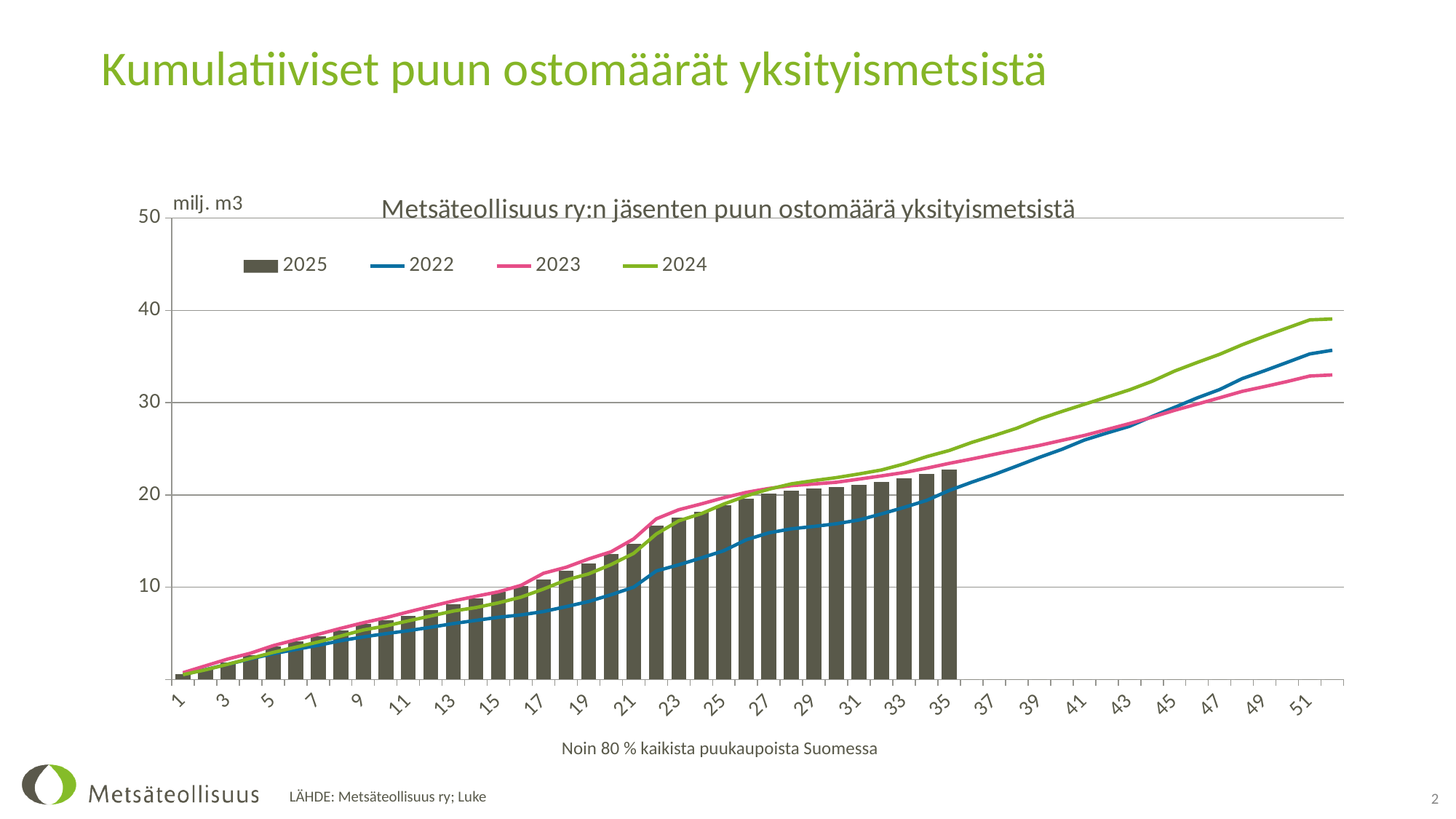
Which series has the highest value at week 51? 2024 Is the value of the 2025 bar at week 1 greater or less than 10? less Is the value of the 2025 bar at week 35 greater or less than 20? greater What kind of chart is shown on the slide? A combined bar and line chart Do the values of the 2022 line rise or fall as the week number increases? rise Which series has the lowest value at week 51? 2023 At week 35, which is larger: the 2023 line or the 2022 line? 2023 Which series is drawn as bars rather than a line? 2025 How many series does the chart legend list? 4 Is the value of the 2023 line at week 51 greater or less than 40? less What is the chart's title? Metsäteollisuus ry:n jäsenten puun ostomäärä yksityismetsistä